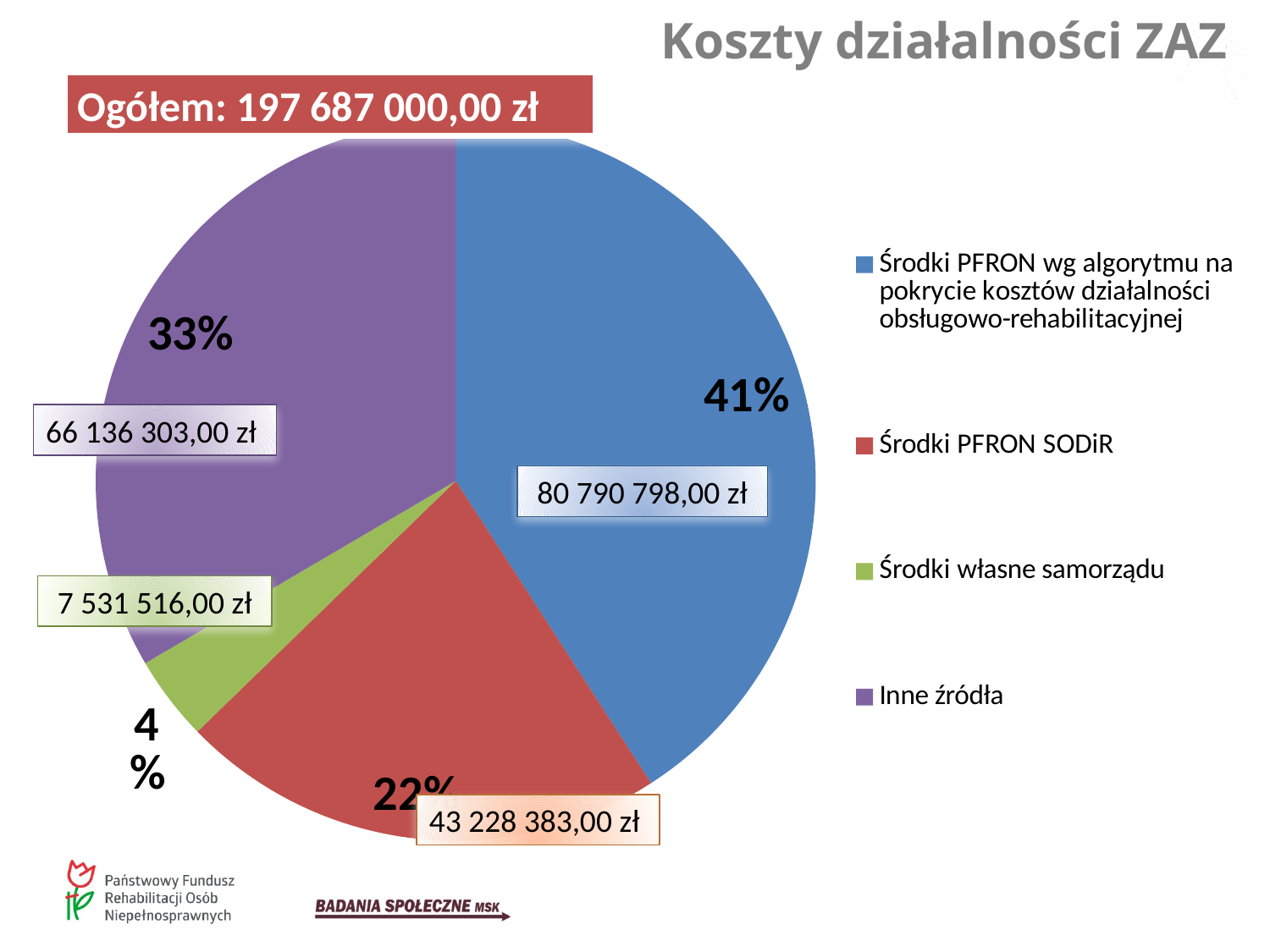
What share of the pie does "Środki własne samorządu" represent? 4% What type of chart is shown on the slide? pie chart Which category has the smallest share of the pie? Środki własne samorządu Which category has the largest share of the pie? Środki PFRON wg algorytmu na pokrycie kosztów działalności obsługowo-rehabilitacyjnej What total amount (Ogółem) is shown on the slide? 197 687 000,00 zł What is the value shown for "Środki PFRON SODiR"? 43 228 383,00 zł What is the value shown for "Inne źródła"? 66 136 303,00 zł What share of the pie does "Inne źródła" represent? 33% What share of the pie does "Środki PFRON SODiR" represent? 22% How many slices does the pie chart have? 4 What is the value shown for "Środki własne samorządu"? 7 531 516,00 zł How many entries does the legend list? 4